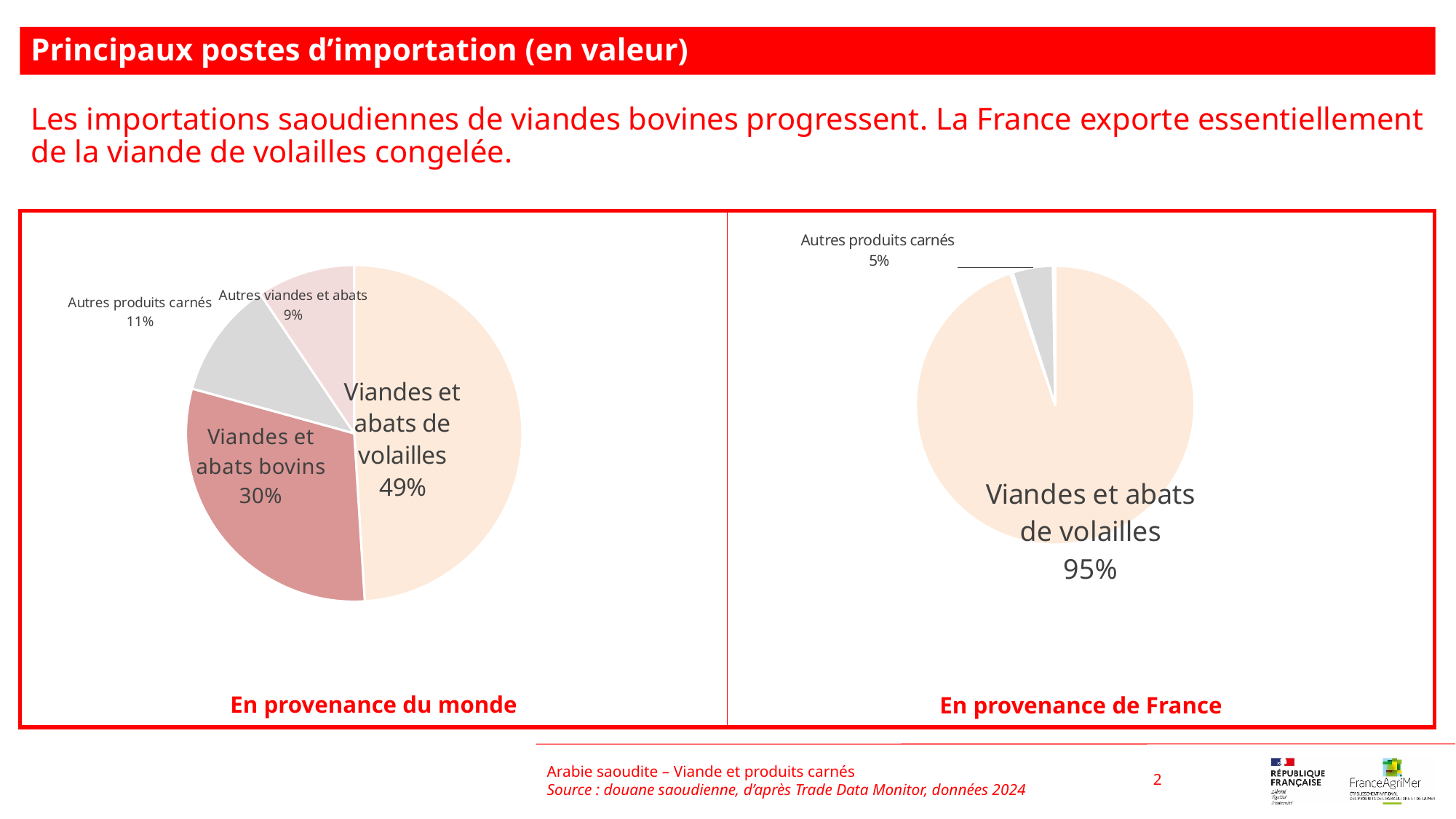
In the 'En provenance du monde' chart, what is the difference in percentage points between Viandes et abats de volailles and Viandes et abats bovins? 19 percentage points In the 'En provenance du monde' chart, which category has the smallest share? Autres viandes et abats In the 'En provenance du monde' chart, what share do Viandes et abats bovins represent? 30% What type of chart is used for 'En provenance de France'? Pie chart In the 'En provenance de France' chart, what share do Viandes et abats de volailles represent? 95% In the 'En provenance du monde' chart, how many categories are shown? 4 In the 'En provenance du monde' chart, what share do Viandes et abats de volailles represent? 49% In the 'En provenance du monde' chart, what share do Autres produits carnés represent? 11% In the 'En provenance du monde' chart, which category has the largest share? Viandes et abats de volailles In the 'En provenance de France' chart, how many categories are shown? 2 In the 'En provenance de France' chart, what share do Autres produits carnés represent? 5% In the 'En provenance du monde' chart, what share do Autres viandes et abats represent? 9%